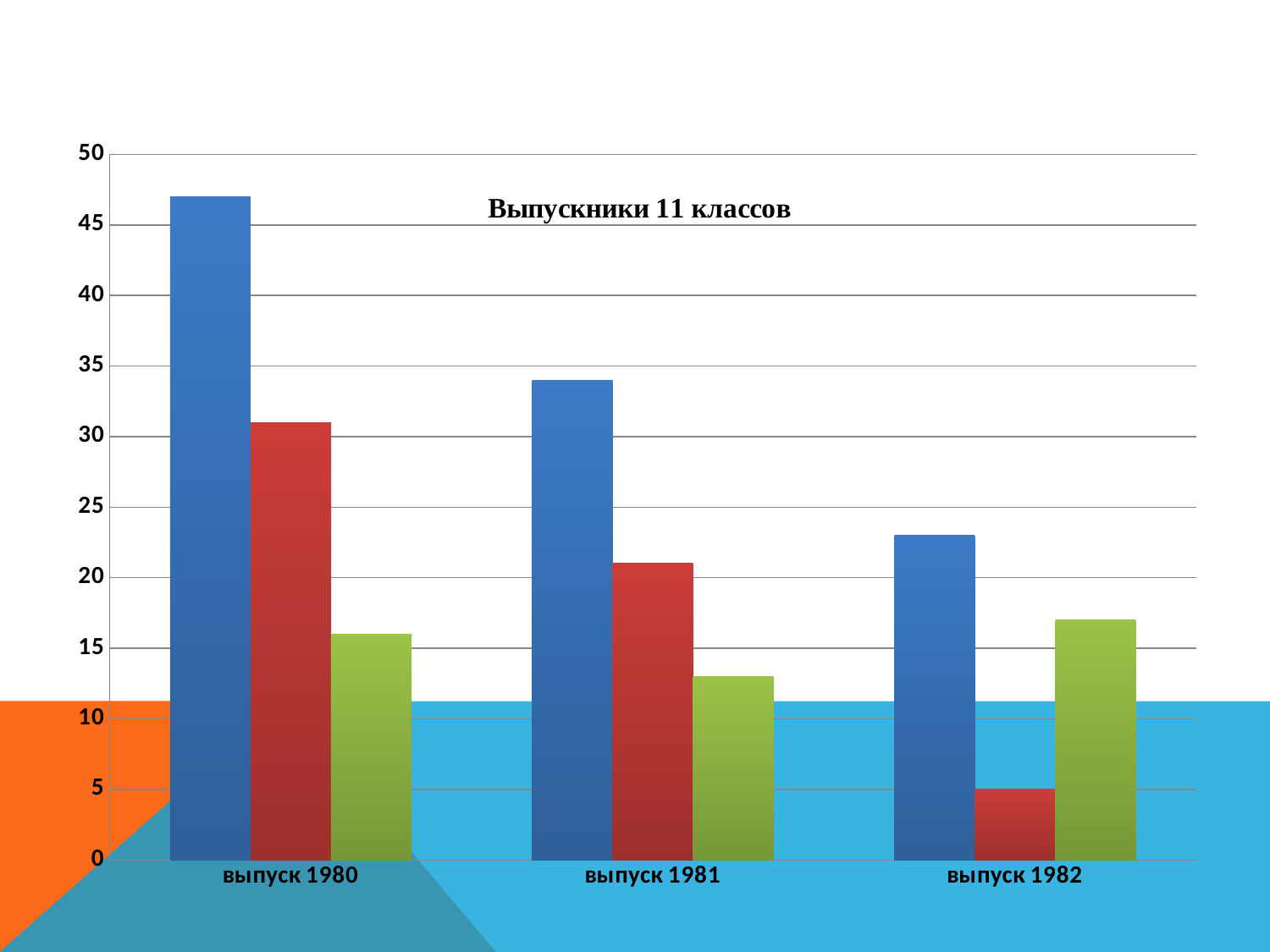
Which category has the highest blue bar? выпуск 1980 What kind of chart is shown on the slide? bar chart How many bars are shown for each category? 3 How many categories are shown on the x axis? 3 Which is larger for выпуск 1982, the blue bar or the green bar? the blue bar Which category has the lowest red bar? выпуск 1982 Do the blue bars rise or fall from выпуск 1980 to выпуск 1982? fall Is the value of the blue bar for выпуск 1980 greater or less than 45? greater Is the value of the green bar for выпуск 1981 greater or less than 15? less What is the title of the chart? Выпускники 11 классов Is the value of the red bar for выпуск 1982 greater or less than 10? less